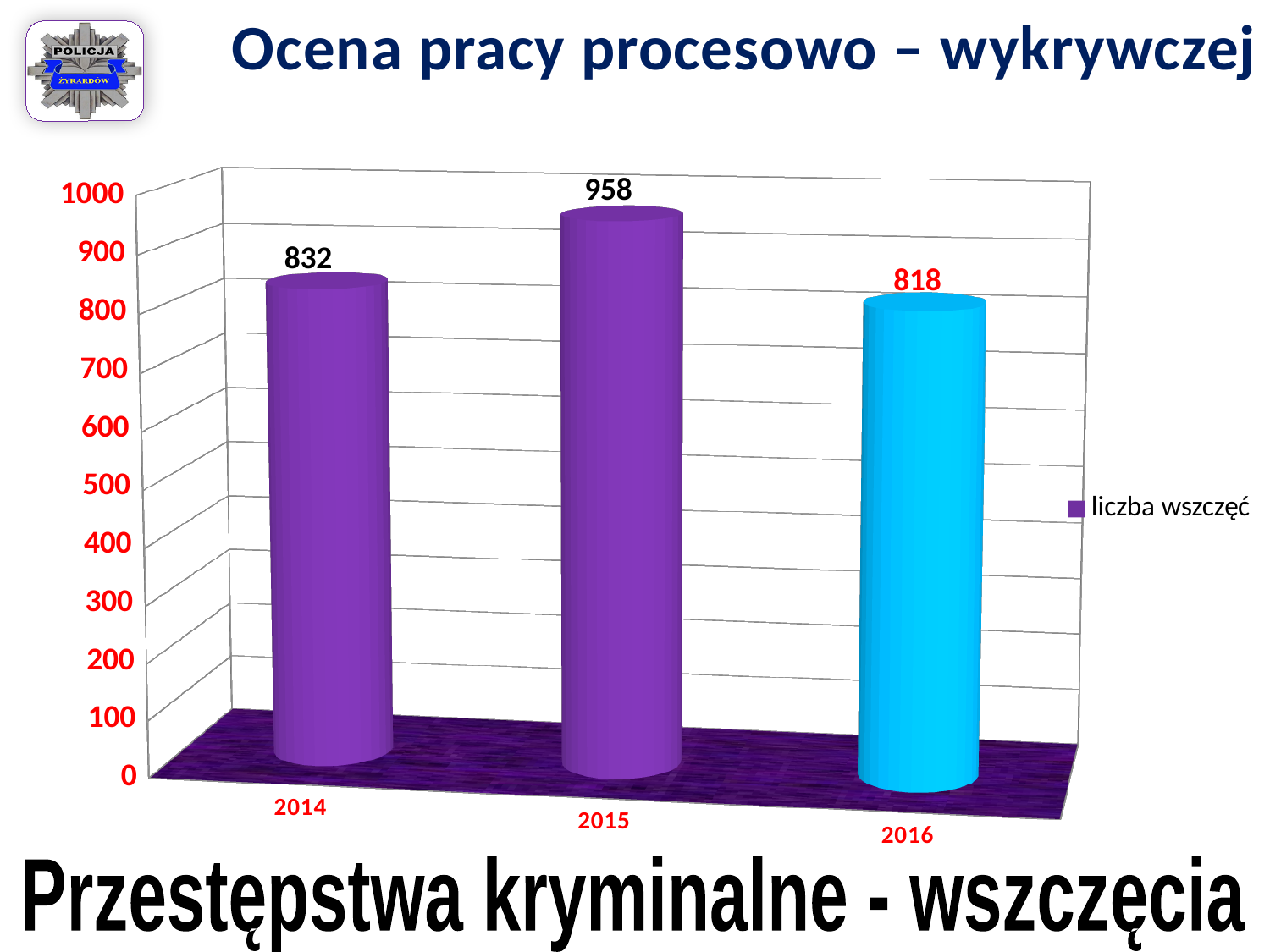
What is the value for 2016? 818 How many years are shown on the x axis? 3 What is the difference between the values for 2015 and 2014? 126 Which year has the highest value? 2015 What is the difference between the values for 2015 and 2016? 140 Which year has the lowest value? 2016 What series name does the legend list? liczba wszczęć What is the value for 2014? 832 What is the value for 2015? 958 What kind of chart is shown on the slide? bar chart Is the value for 2015 greater or less than 900? greater Which is larger, the value for 2014 or the value for 2016? 2014